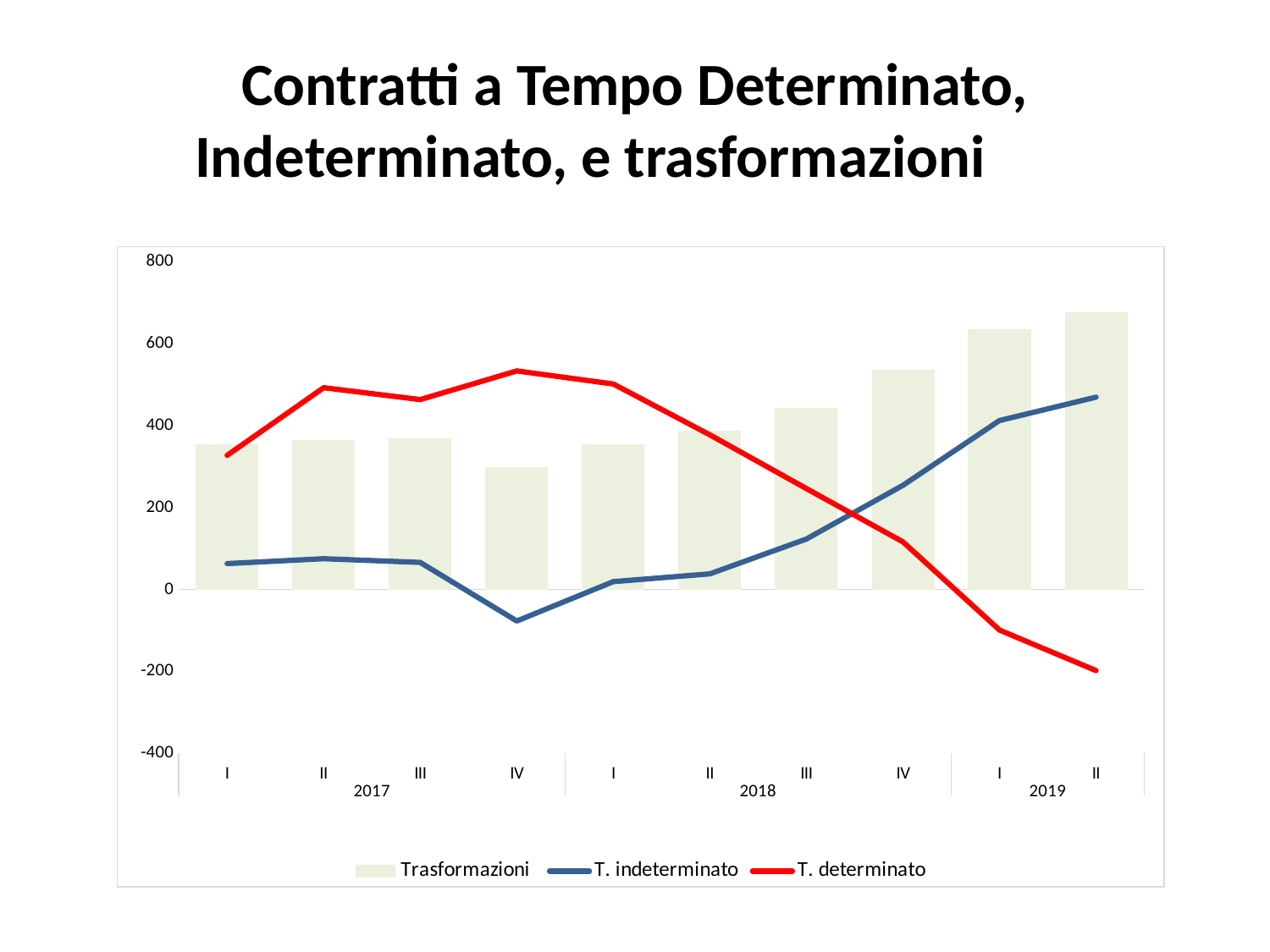
Does the T. determinato line rise or fall from IV 2017 to II 2019? It falls In which quarter does the T. determinato line reach its lowest value? II 2019 What kind of chart is shown on the slide? A combined bar and line chart Is the Trasformazioni value in II 2019 greater or less than 600? greater In which quarter does the T. indeterminato line reach its lowest value? IV 2017 In I 2017, which is higher: T. determinato or T. indeterminato? T. determinato How many series does the legend list? 3 In which quarter does the T. indeterminato line reach its highest value? II 2019 In which quarter is the Trasformazioni bar lowest? IV 2017 In which quarter is the Trasformazioni bar highest? II 2019 How many quarters are plotted along the x axis? 10 Is the value of T. determinato in I 2019 greater or less than 0? less